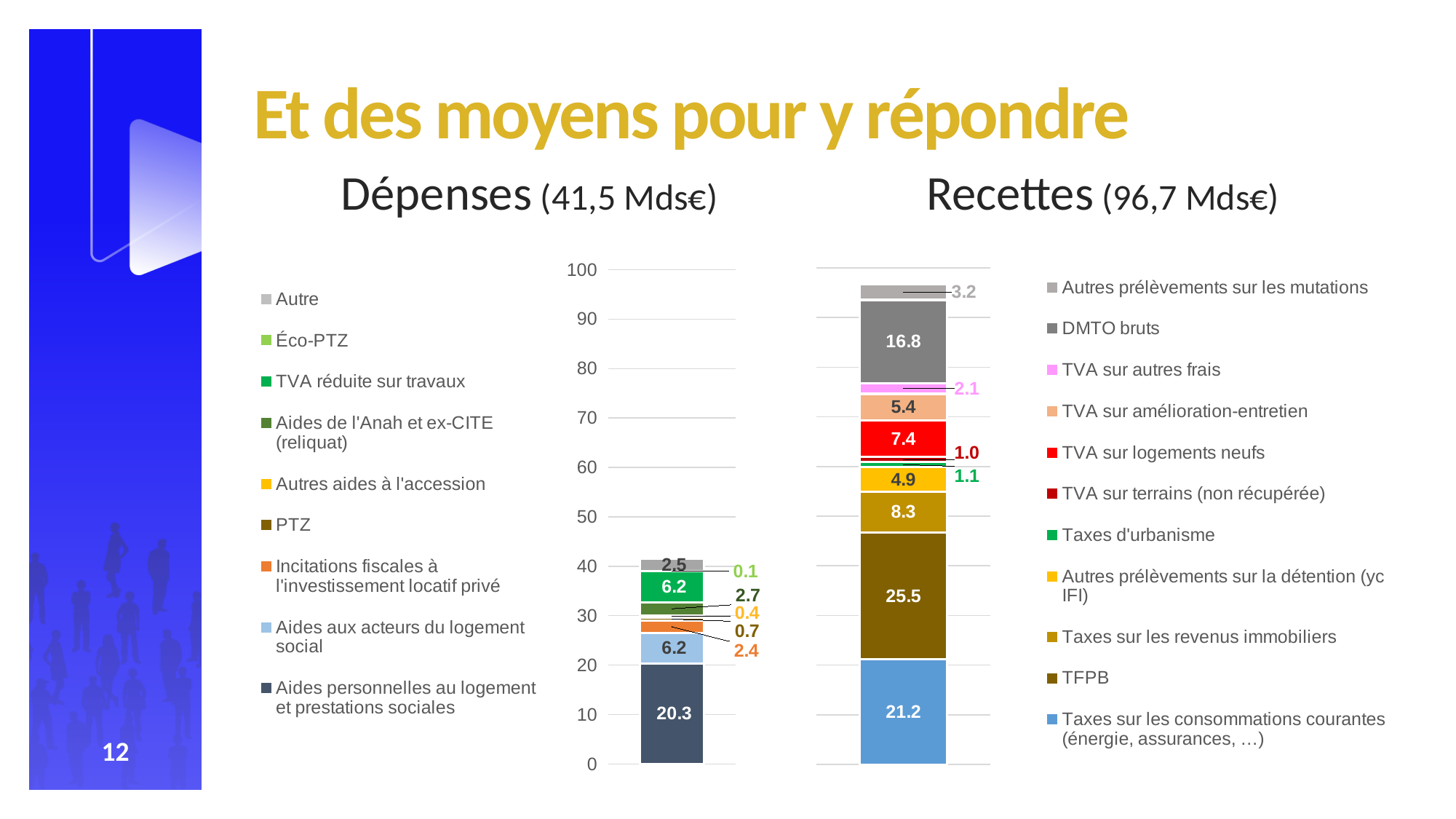
In the Recettes chart, what is the value for DMTO bruts? 16.8 How many series does the legend of the Dépenses chart list? 9 In the Dépenses chart, which series has the smallest segment? Éco-PTZ What type of chart is the Dépenses chart? Stacked bar chart In the Dépenses chart, what is the value for Aides personnelles au logement et prestations sociales? 20.3 In the Recettes chart, what is the difference between TFPB and Taxes sur les consommations courantes? 4.3 In the Dépenses chart, what is the total of the stacked bar? 41.5 In the Dépenses chart, which is larger: TVA réduite sur travaux or Aides de l'Anah et ex-CITE (reliquat)? TVA réduite sur travaux In the Recettes chart, which series has the largest segment? TFPB In the Recettes chart, what is the value for TVA sur logements neufs? 7.4 In the Dépenses chart, what is the value for Incitations fiscales à l'investissement locatif privé? 2.4 How many series does the legend of the Recettes chart list? 11